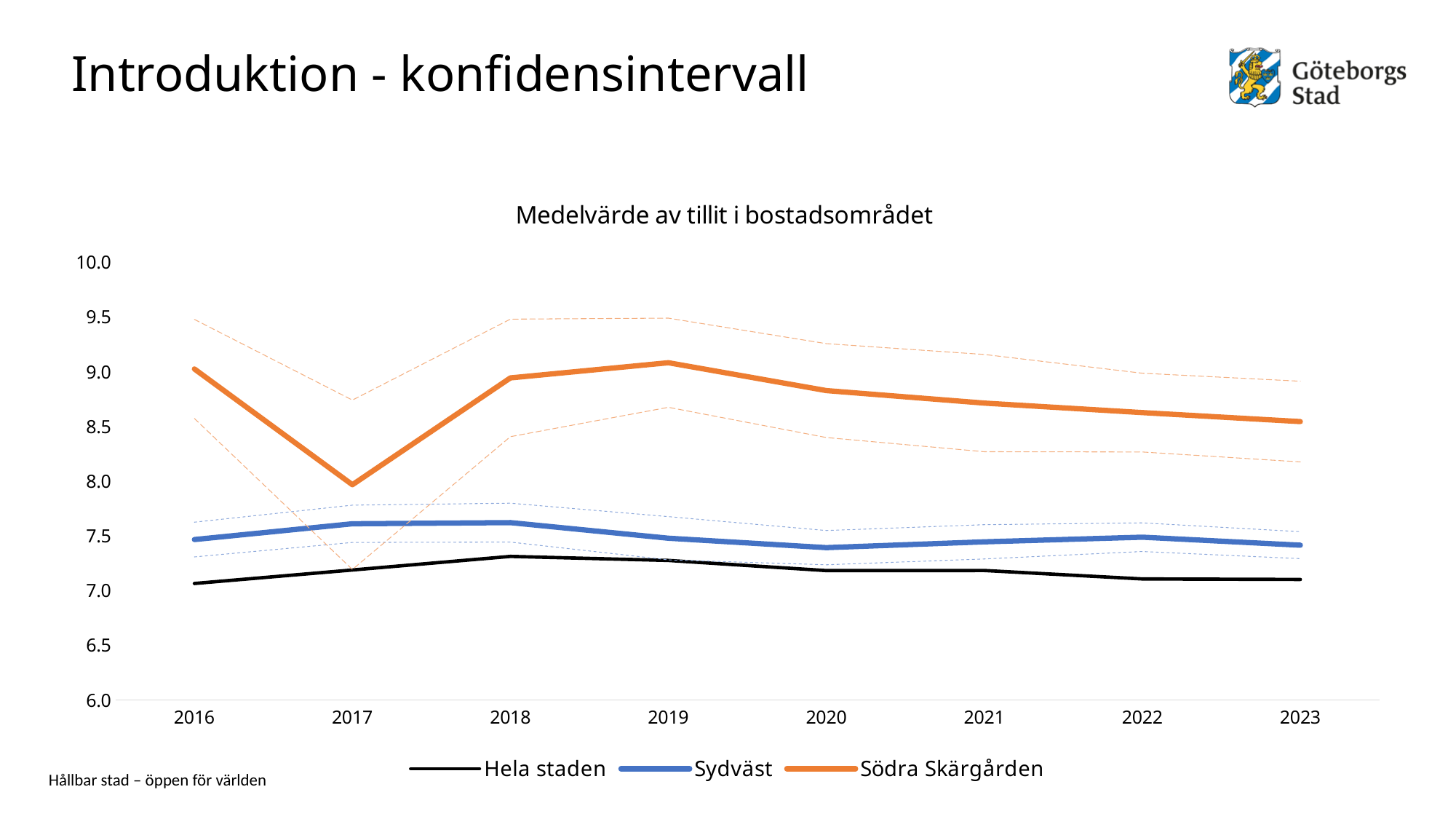
Which series has the lowest values across all years? Hela staden Does the value for Södra Skärgården rise or fall from 2019 to 2023? Fall Is the value for Södra Skärgården in 2020 greater or less than 9.0? less What kind of chart is shown on the slide? Line chart In 2017, which is larger: the value for Södra Skärgården or the value for Sydväst? Södra Skärgården Is the value for Sydväst in 2018 greater or less than 7.5? greater Which colour is used for the Södra Skärgården line? Orange How many series does the legend list? 3 In which year is the value for Södra Skärgården lowest? 2017 What is the title of the chart? Medelvärde av tillit i bostadsområdet Is the value for Hela staden in 2018 greater or less than 7.5? less How many years are shown on the x axis? 8